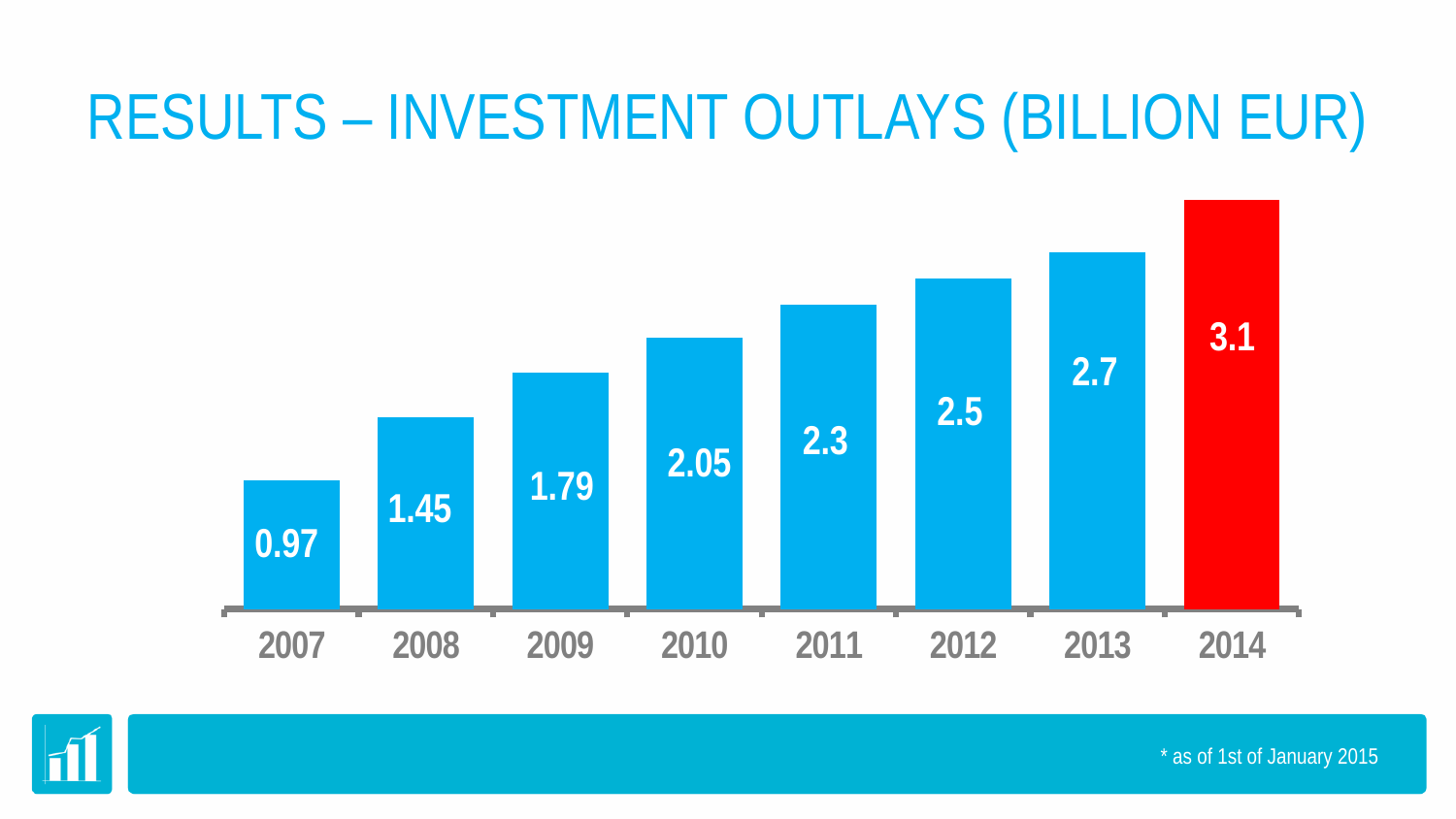
Which year has the highest investment outlay? 2014 Do the investment outlays rise or fall from 2007 to 2014? rise What is the investment outlay value for 2007? 0.97 Which year has the lowest investment outlay? 2007 What is the investment outlay value for 2010? 2.05 Which year's bar is coloured red instead of blue? 2014 What kind of chart is shown on the slide? bar chart How many years are shown on the chart? 8 What is the difference between the investment outlays for 2014 and 2013? 0.4 What is the investment outlay value for 2013? 2.7 What is the difference between the investment outlays for 2009 and 2008? 0.34 Which year has a larger investment outlay, 2011 or 2012? 2012